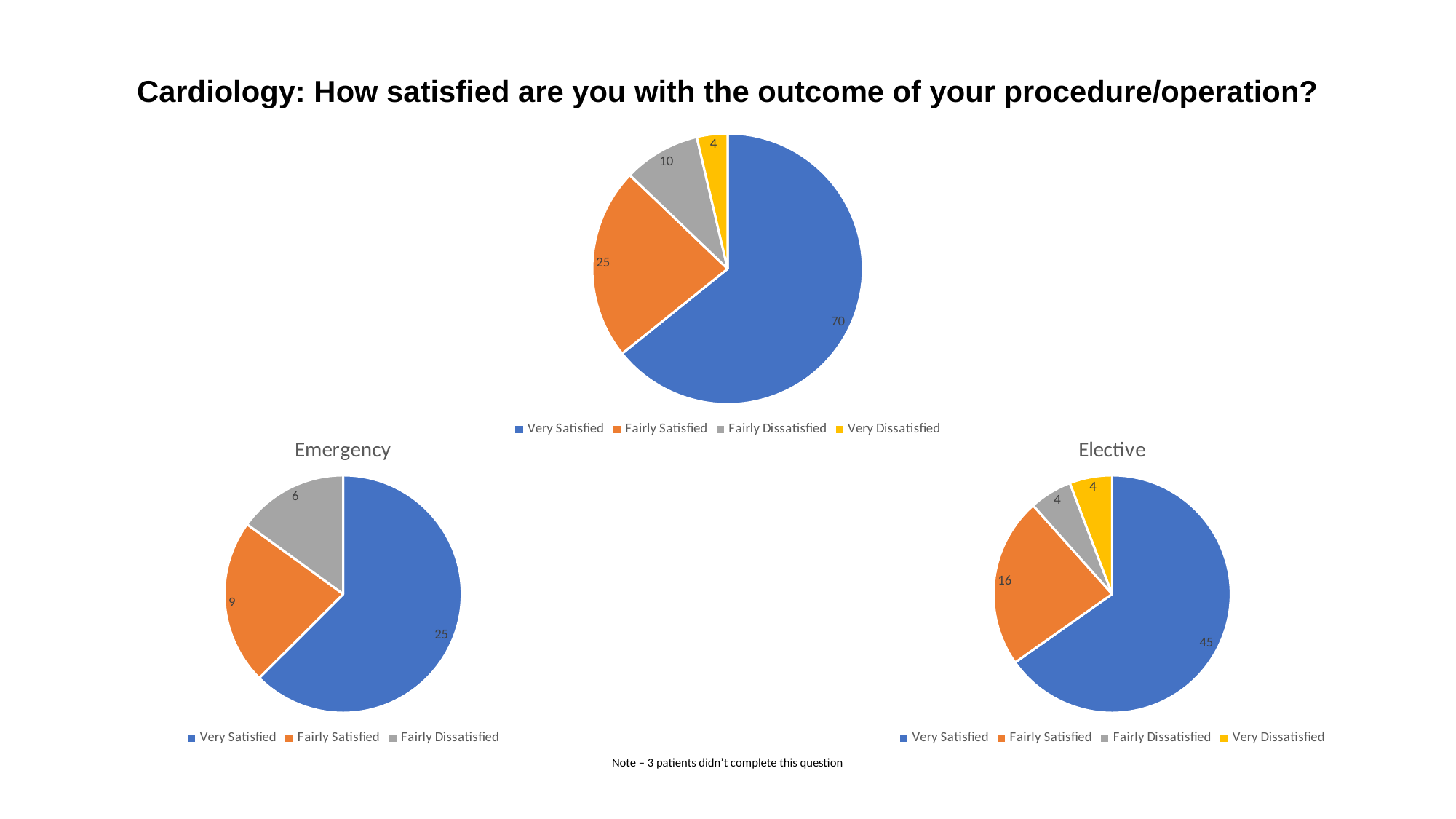
In the top pie chart, what is the difference between Fairly Satisfied and Fairly Dissatisfied? 15 What type of chart is used for the Elective data? Pie chart How many categories does the Emergency pie chart show? 3 In the Emergency pie chart, which category has the largest slice? Very Satisfied How many categories does the Elective pie chart show? 4 In the Elective pie chart, what is the difference between Very Satisfied and Fairly Satisfied? 29 In the Emergency pie chart, which is larger, Fairly Satisfied or Fairly Dissatisfied? Fairly Satisfied In the top pie chart, what is the value for Very Satisfied? 70 In the Elective pie chart, what is the value for Fairly Satisfied? 16 In the Emergency pie chart, what share of the total does Very Satisfied represent? 62.5% In the top pie chart, which category has the smallest slice? Very Dissatisfied In the Emergency pie chart, what is the value for Fairly Satisfied? 9